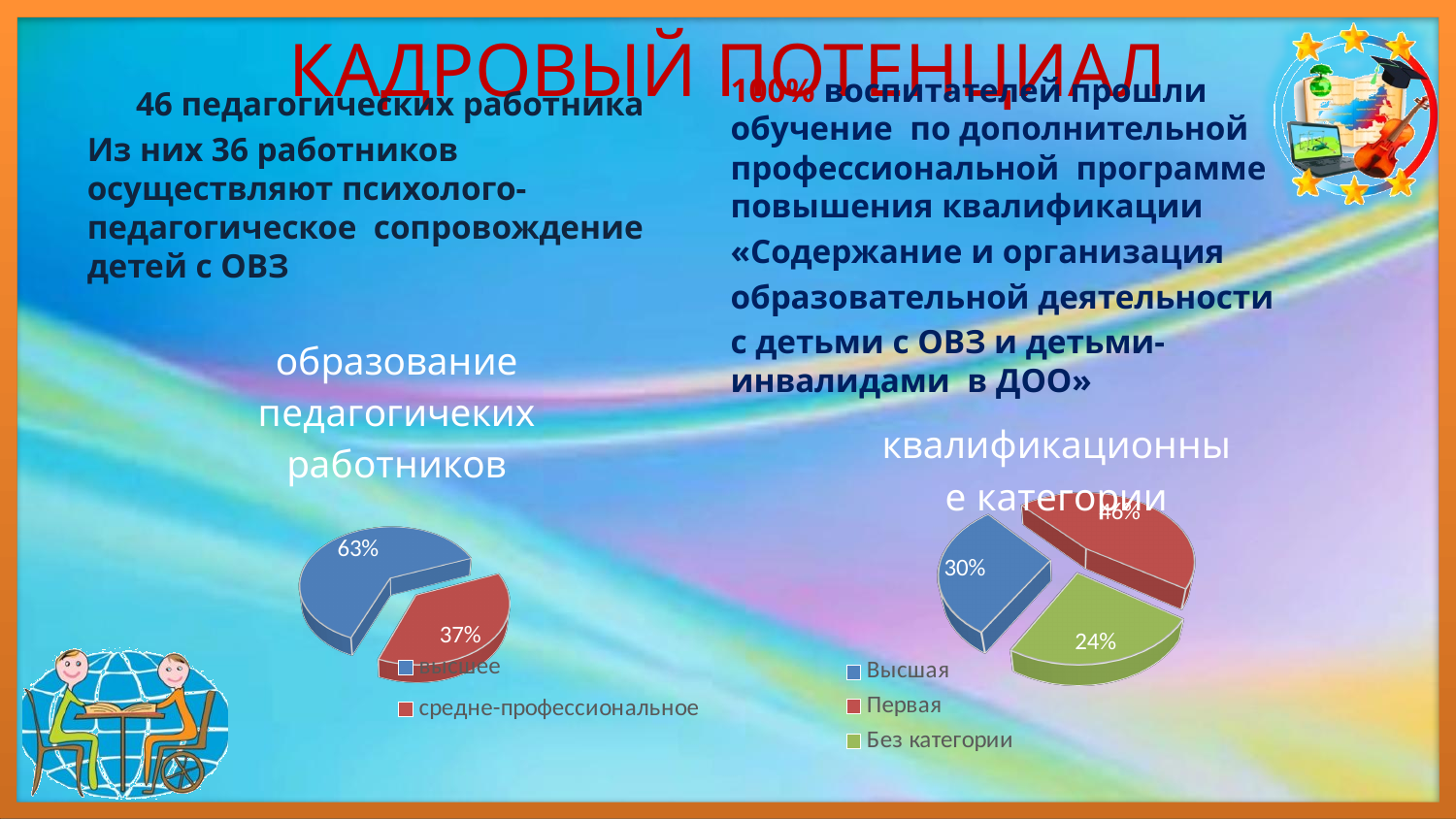
What kind of chart is the chart titled "квалификационные категории"? pie chart In the chart titled "квалификационные категории", what share is labelled for Высшая? 30% In the chart titled "образование педагогичеких работников", what is the difference in percentage points between высшее and средне-профессиональное? 26 How many slices does the chart titled "образование педагогичеких работников" have? 2 In the chart titled "образование педагогичеких работников", what share is labelled for the blue slice (высшее)? 63% In the chart titled "образование педагогичеких работников", which category has the larger share? высшее In the chart titled "квалификационные категории", what share is labelled for Без категории? 24% How many categories does the legend of the chart titled "квалификационные категории" list? 3 In the chart titled "квалификационные категории", which category has the smallest share? Без категории In the chart titled "образование педагогичеких работников", what share is labelled for средне-профессиональное? 37% In the chart titled "квалификационные категории", which is larger: the share for Высшая or the share for Без категории? Высшая What kind of chart is the chart titled "образование педагогичеких работников"? pie chart